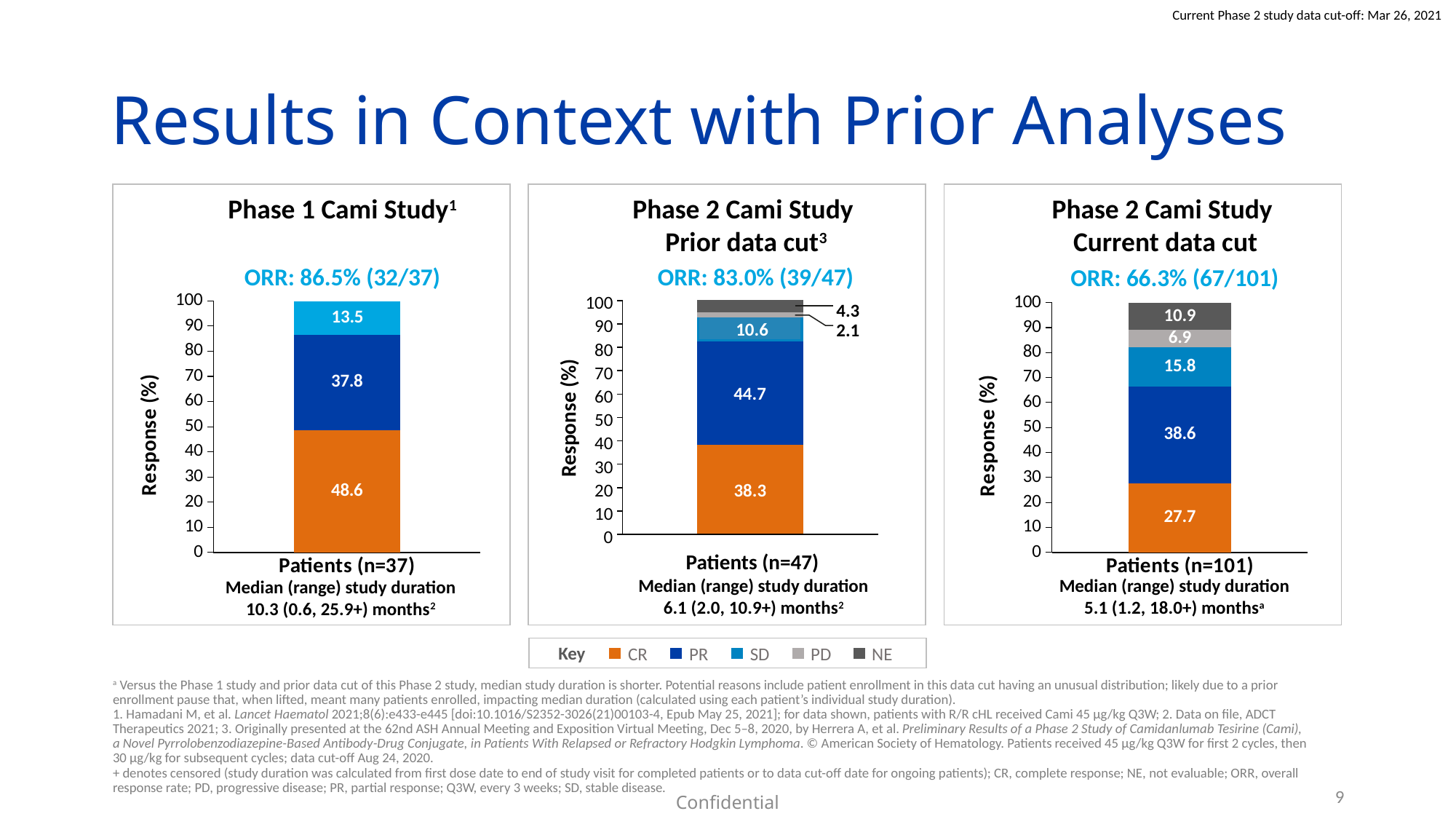
In the Phase 2 Cami Study Current data cut chart, what is the NE value? 10.9 In the Phase 2 Cami Study Current data cut chart, which response category has the largest segment? PR How many response categories does the Key list? 5 Is the CR value larger in the Phase 1 Cami Study chart or in the Phase 2 Cami Study Current data cut chart? Phase 1 Cami Study What kind of chart is used in the Phase 2 Cami Study Prior data cut panel? Stacked bar chart In the Phase 2 Cami Study Current data cut chart, is the CR value greater or less than 30? less In the Phase 2 Cami Study Prior data cut chart, what is the combined value of the PD and NE segments? 6.4 What ORR is shown above the Phase 2 Cami Study Current data cut chart? 66.3% (67/101) In the Phase 1 Cami Study chart, what is the difference between the CR and PR values? 10.8 In the Phase 2 Cami Study Prior data cut chart, what is the PR value? 44.7 In the Phase 2 Cami Study Prior data cut chart, which response category has the smallest segment? PD In the Phase 1 Cami Study chart, what is the CR (complete response) value? 48.6